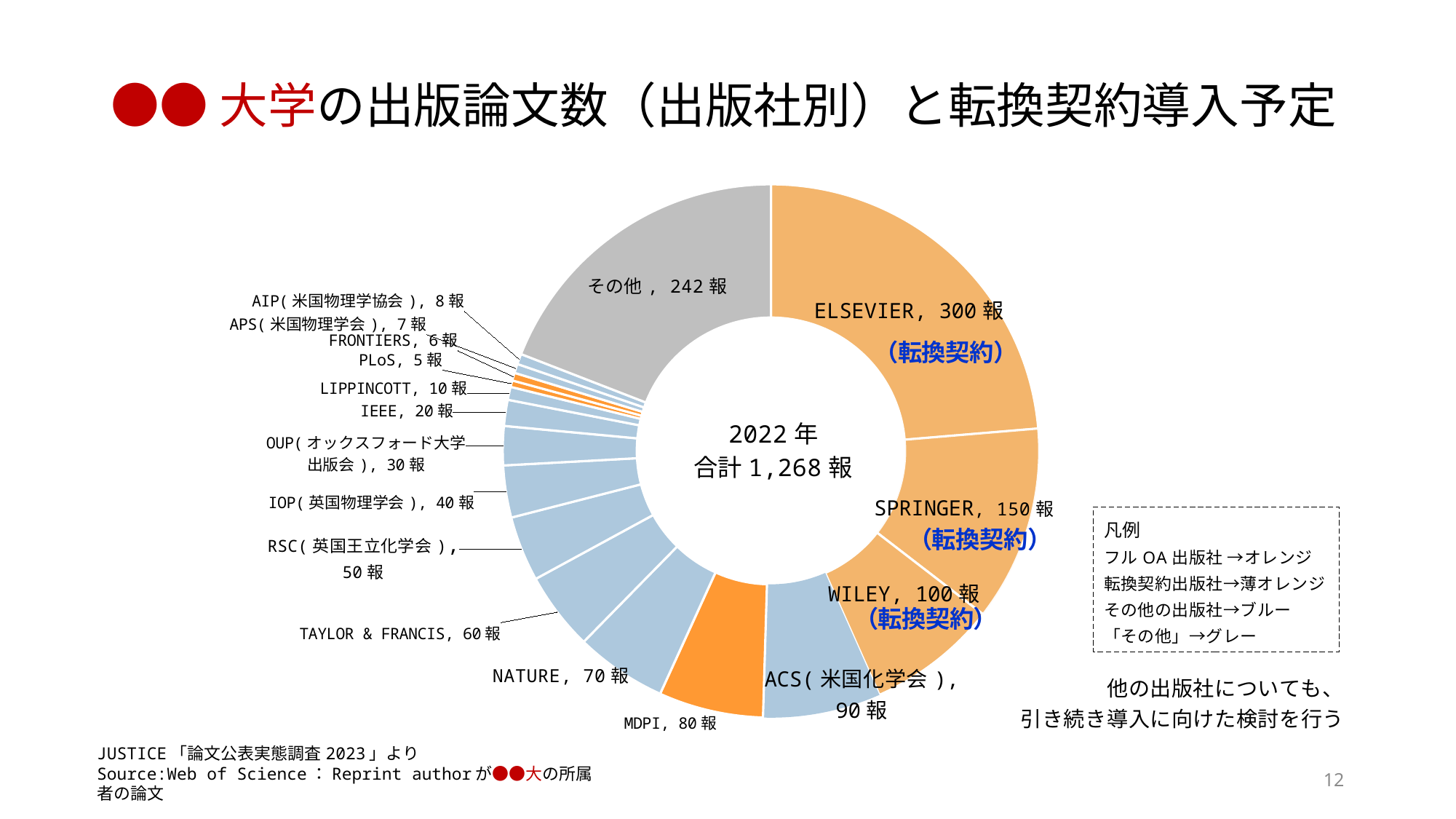
このグラフはどの種類のグラフですか？ 円グラフ（ドーナツグラフ） SPRINGERの出版論文数は何報ですか？ 150報 WILEYとACS（米国化学会）では、どちらの出版論文数が多いですか？ WILEY 凡例によると、フルOA出版社は何色で示されていますか？ オレンジ グラフには「その他」を含めていくつの区分がありますか？ 17 MDPIの出版論文数は何報ですか？ 80報 2022年の出版論文数の合計は何報ですか？ 1,268報 出版社名が示されている中で、出版論文数が最も多い出版社はどこですか？ ELSEVIER ELSEVIERの出版論文数は何報ですか？ 300報 ELSEVIERとSPRINGERの出版論文数の差は何報ですか？ 150報 出版論文数が最も少ない出版社はどこですか？ PLoS 「その他」の出版論文数は何報ですか？ 242報